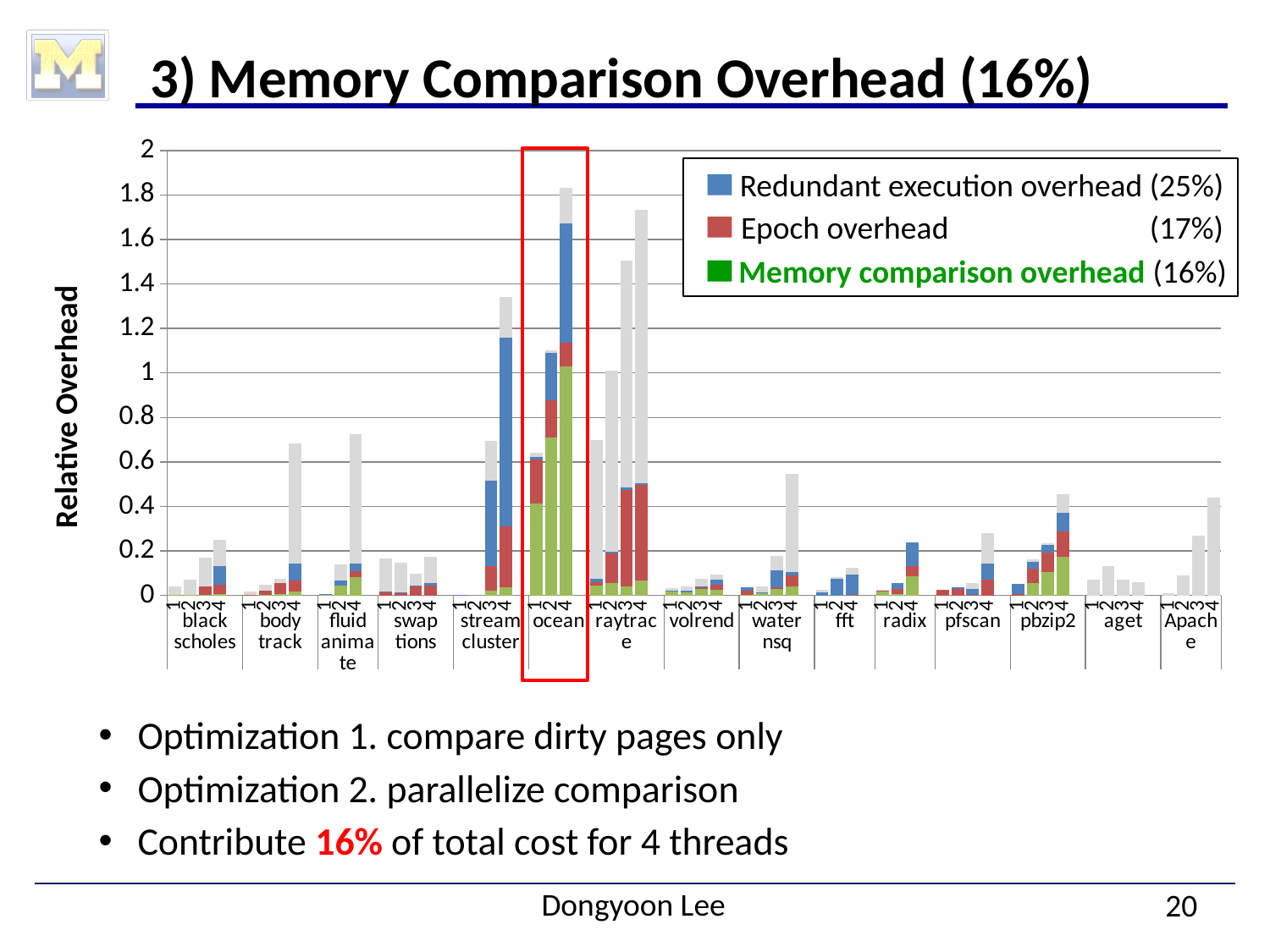
What percentage is shown in the legend next to 'Memory comparison overhead'? 16% Within the ocean group, does the total overhead rise or fall as the thread count goes from 1 to 4? rise Which has the larger total overhead at 4 threads: ocean or volrend? ocean Is the total overhead for streamcluster with 4 threads greater or less than 1.2? greater Is the total overhead for Apache with 4 threads greater or less than 0.6? less Is the total overhead for ocean with 4 threads greater or less than 1.6? greater What kind of chart is shown on the slide? stacked bar chart How many series does the chart legend list? 3 What is the label on the y axis of the chart? Relative Overhead How many benchmark groups are labelled along the x axis? 15